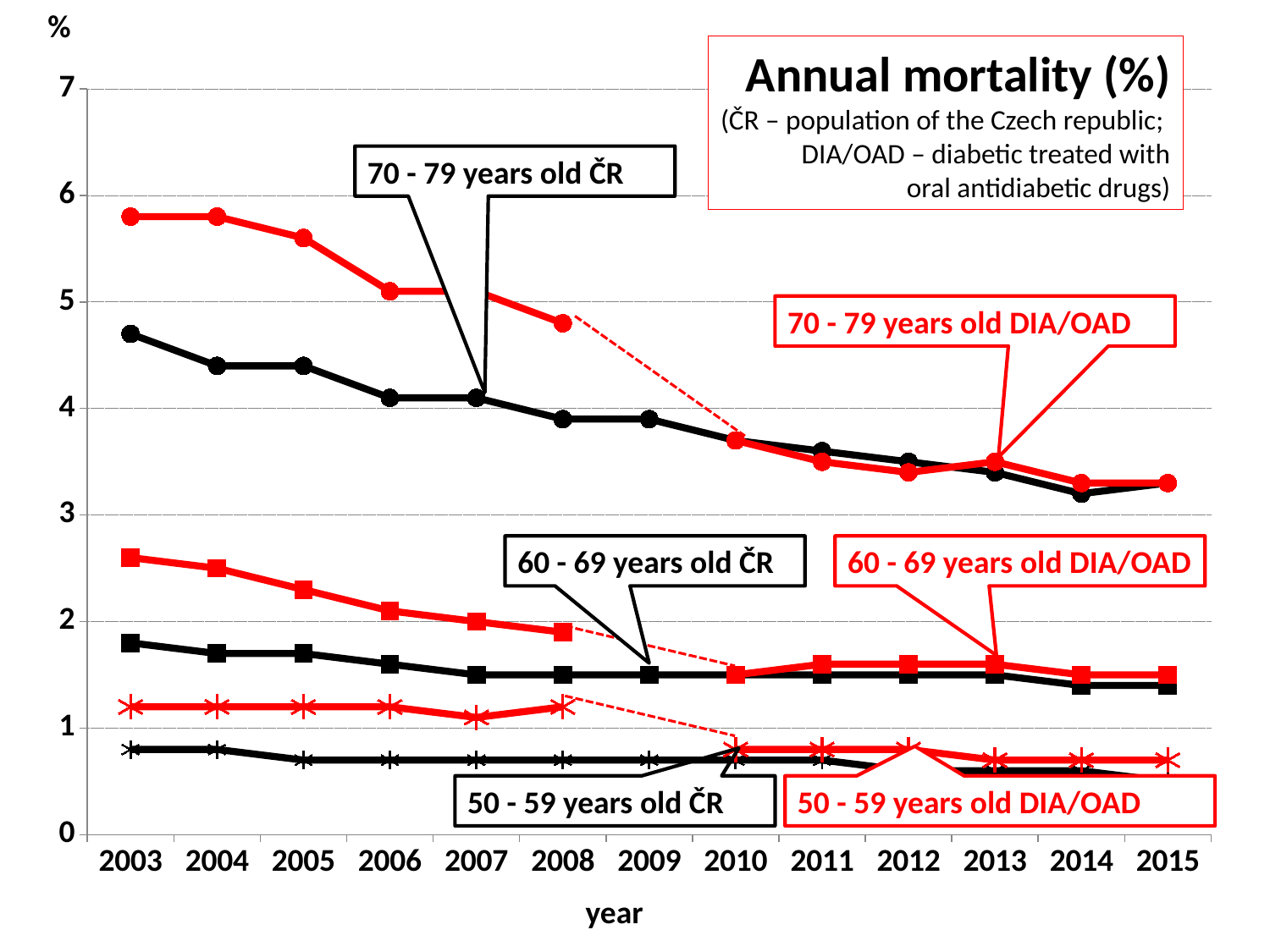
Does the 70 - 79 years old DIA/OAD series rise or fall from 2003 to 2015? fall Is the value for 50 - 59 years old ČR in 2003 greater or less than 1? less Is the value for 70 - 79 years old ČR in 2003 greater or less than 4? greater Is the value for 70 - 79 years old DIA/OAD in 2003 greater or less than 5? greater In 2003, which is larger: 60 - 69 years old DIA/OAD or 60 - 69 years old ČR? 60 - 69 years old DIA/OAD How many data series are labelled on the chart? 6 What is the title of the chart? Annual mortality (%) What is the label of the x axis? year How many years are shown along the x axis? 13 What kind of chart is shown on the slide? line chart Which series has the highest value in 2003? 70 - 79 years old DIA/OAD